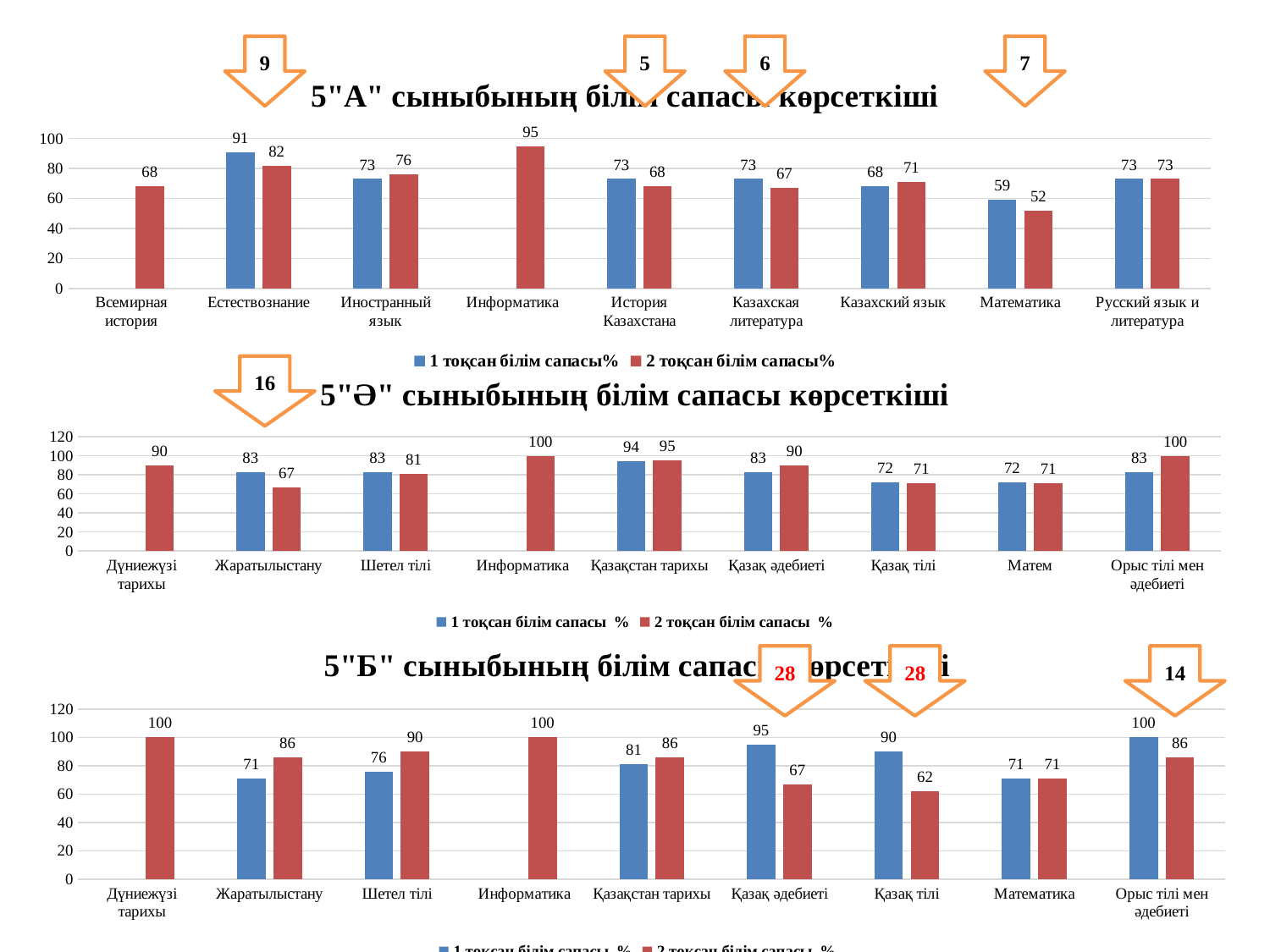
In the middle chart (5"Ә" сыныбының білім сапасы көрсеткіші), what is the 2 тоқсан білім сапасы % value for Орыс тілі мен әдебиеті? 100 How many series does the legend of the middle chart (5"Ә") list? 2 What type of chart is the bottom chart (5"Б")? Bar chart In the middle chart (5"Ә"), which is larger for Қазақ әдебиеті: the 1 тоқсан value or the 2 тоқсан value? 2 тоқсан білім сапасы % In the middle chart (5"Ә"), which category has the lowest 2 тоқсан білім сапасы % value? Жаратылыстану In the bottom chart (5"Б"), what is the difference between the 1 тоқсан and 2 тоқсан values for Қазақ әдебиеті? 28 In the top chart (5"А"), what is the difference between the 1 тоқсан and 2 тоқсан values for Естествознание? 9 In the top chart (5"А"), which category has the highest 2 тоқсан білім сапасы% value? Информатика In the bottom chart (5"Б"), what is the 2 тоқсан білім сапасы % value for Қазақ тілі? 62 In the top chart (5"А"), what is the value of 2 тоқсан білім сапасы% for Математика? 52 In the top chart (5"А" сыныбының білім сапасы көрсеткіші), what is the value of 1 тоқсан білім сапасы% for Естествознание? 91 How many categories are shown on the x axis of the top chart (5"А")? 9